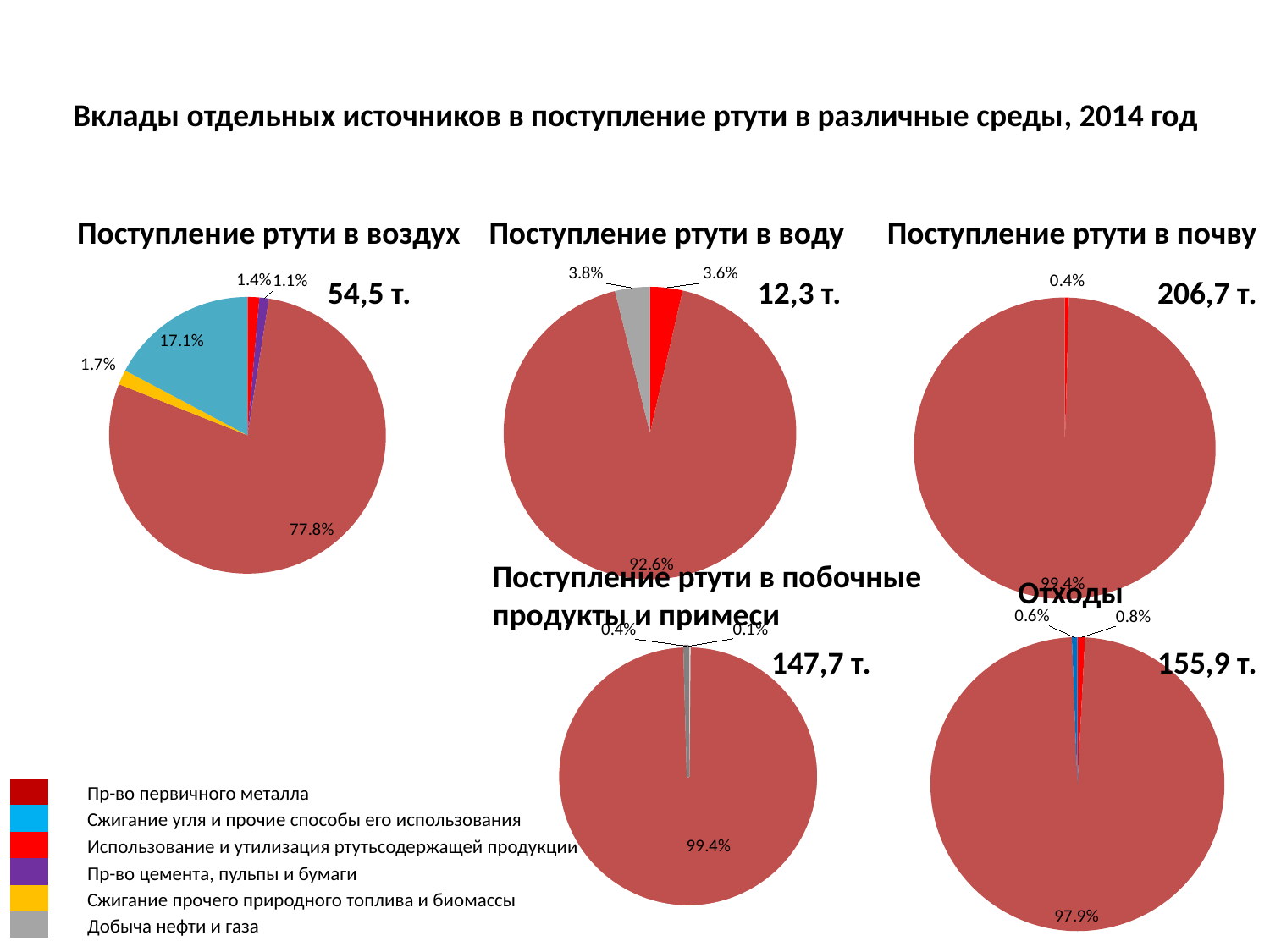
In the chart 'Поступление ртути в побочные продукты и примеси', what total amount is shown next to the pie? 147,7 т. How many entries does the legend at the bottom left of the slide list? 6 What kind of charts are shown on the slide? Pie charts In the chart 'Поступление ртути в воздух', what share is labelled for the blue slice? 17.1% How many pie charts are on the slide? 5 In the chart 'Поступление ртути в воду', what share does the grey slice have? 3.8% In the chart 'Поступление ртути в воздух', what is the total amount shown next to the pie? 54,5 т. In the chart 'Поступление ртути в воздух', what share does the largest slice have? 77.8% In the chart 'Отходы', what share does the smallest labelled slice have? 0.6% In the chart 'Поступление ртути в почву', what share does the largest slice have? 99.4% In the chart 'Поступление ртути в воду', what is the difference between the grey slice (3.8%) and the red slice (3.6%)? 0.2% In the chart 'Поступление ртути в почву', what total amount is shown next to the pie? 206,7 т.